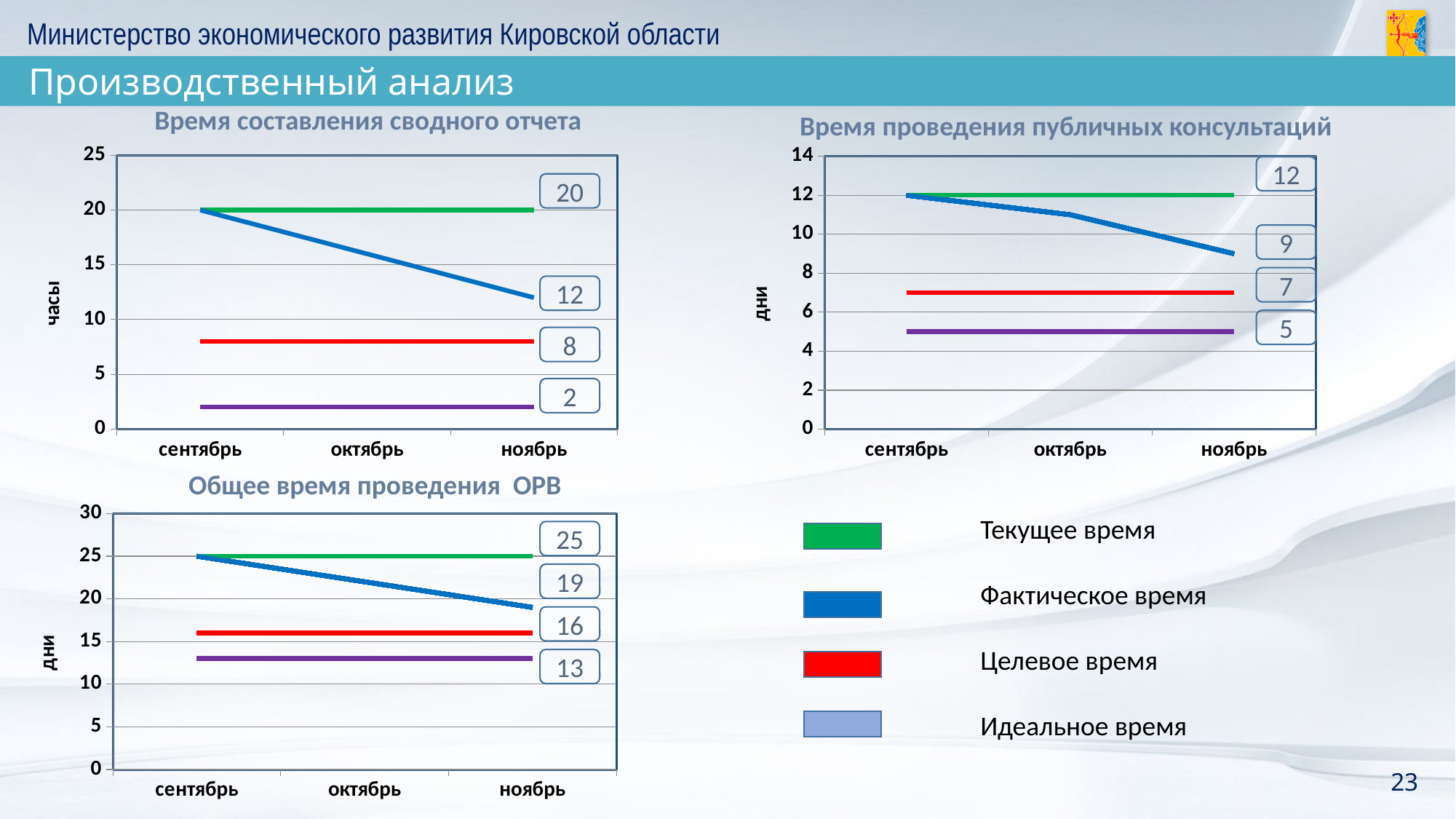
In the chart 'Общее время проведения ОРВ', what is the value of the purple line? 13 In the chart 'Общее время проведения ОРВ', which is larger in ноябрь: Фактическое время or Целевое время? Фактическое время In the chart 'Общее время проведения ОРВ', what is the value of Фактическое время in ноябрь? 19 In the chart 'Время проведения публичных консультаций', what is the value of Текущее время? 12 In the chart 'Время проведения публичных консультаций', what is the difference between Текущее время and Целевое время? 5 In the chart 'Общее время проведения ОРВ', how many months are shown on the x axis? 3 In the chart 'Время составления сводного отчета', what is the value of Целевое время? 8 How many series does the legend on the slide list? 4 In the chart 'Время составления сводного отчета', does Фактическое время rise or fall from сентябрь to ноябрь? fall In the chart 'Время составления сводного отчета', what is the value of Фактическое время in ноябрь? 12 In the chart 'Время проведения публичных консультаций', what is the value of Фактическое время in ноябрь? 9 What kind of chart is 'Время составления сводного отчета'? line chart